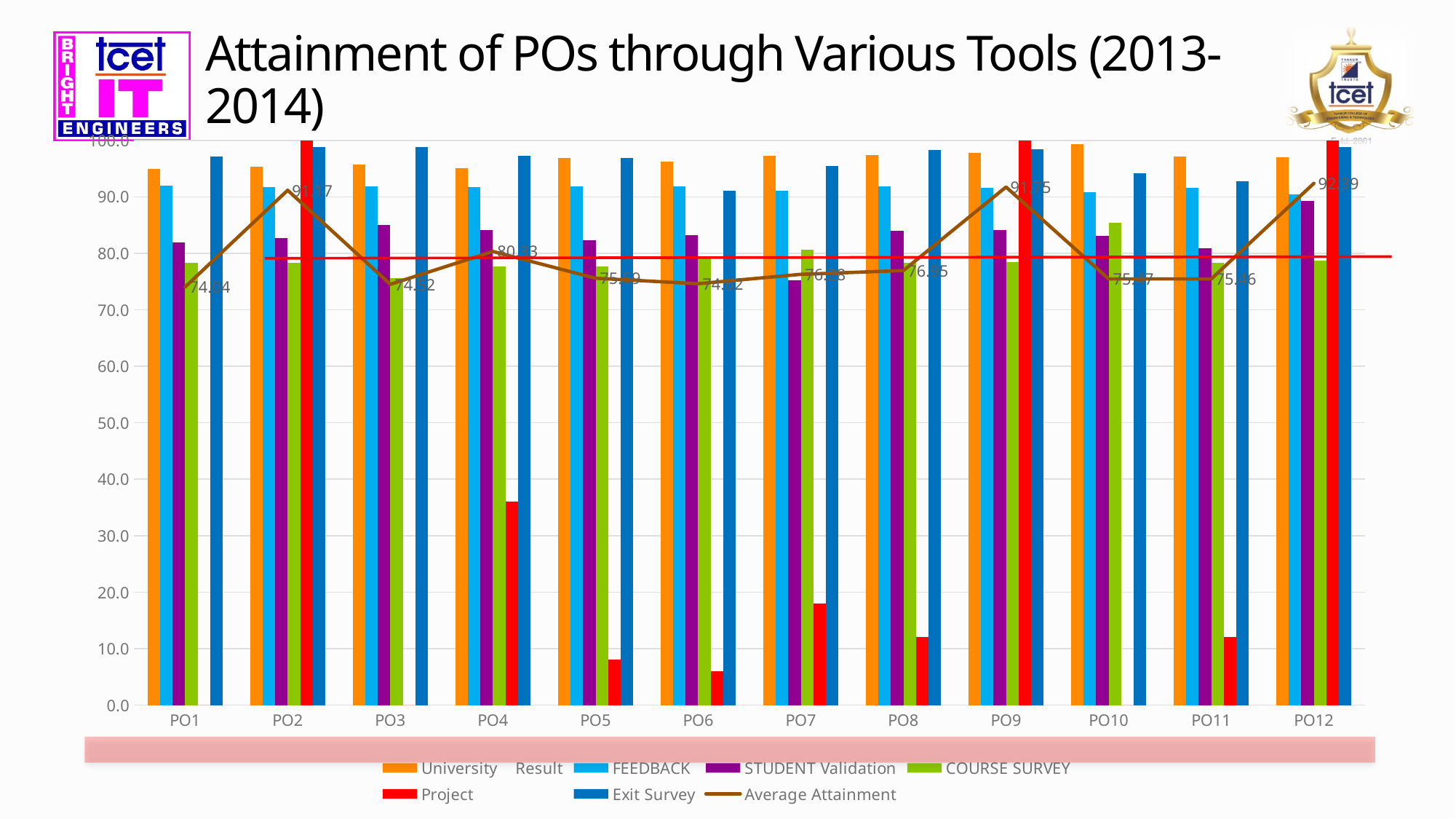
What is the difference between the Average Attainment values for PO4 and PO1? 6.29 Is the Project value for PO4 greater or less than 40? less What is the Average Attainment value for PO1? 74.04 How many PO categories are shown on the x axis? 12 How many series does the legend list? 7 What is the Average Attainment value for PO3? 74.52 What kind of chart is shown on the slide? bar chart with a line What is the Average Attainment value for PO4? 80.33 Which has the larger Average Attainment value, PO4 or PO3? PO4 Is the Exit Survey value for PO1 greater or less than 90? greater What is the Average Attainment value for PO11? 75.46 What is the title of the chart? Attainment of POs through Various Tools (2013-2014)